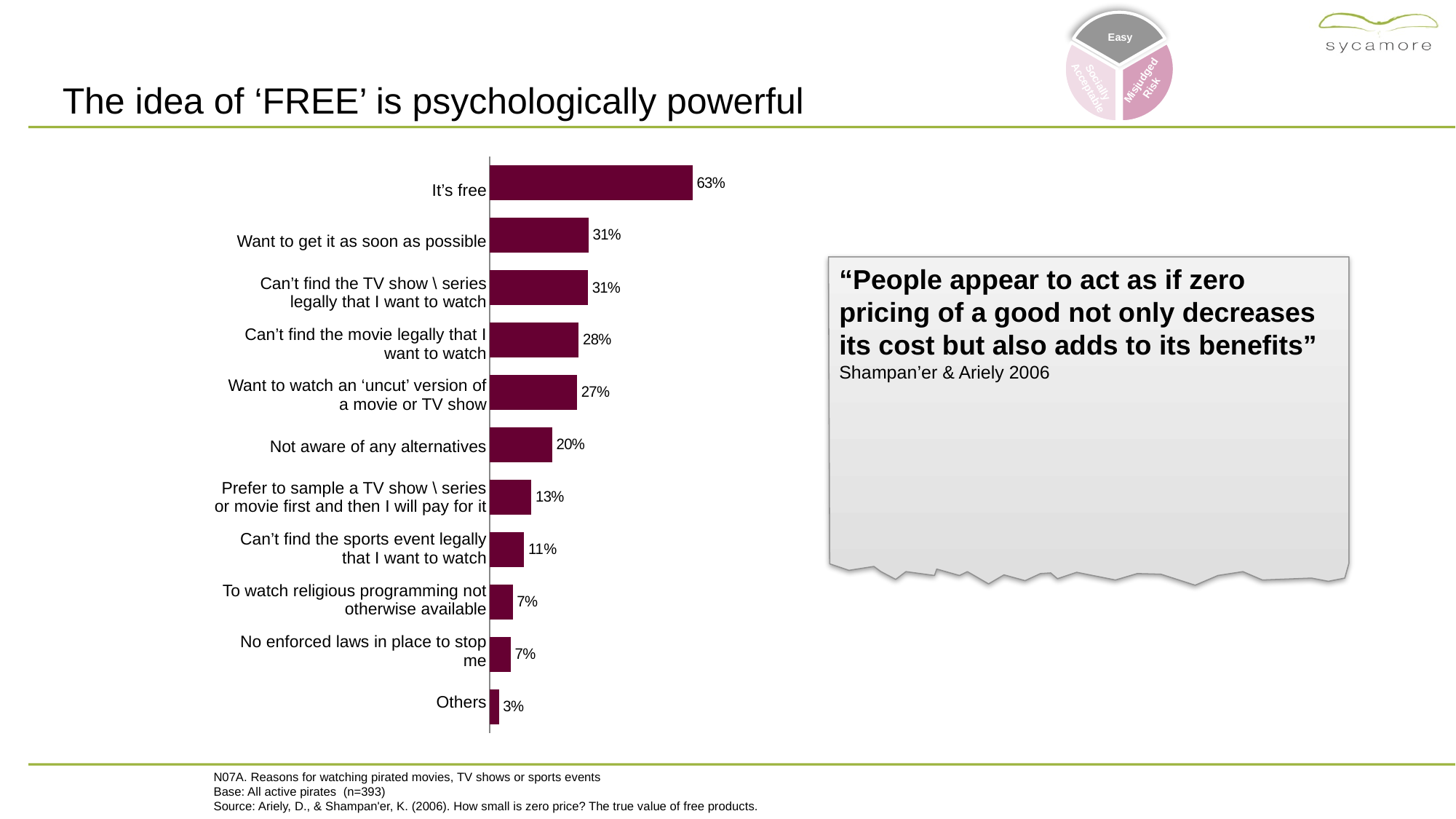
Which two reasons both have a value of 7%? To watch religious programming not otherwise available; No enforced laws in place to stop me Which reason has the highest percentage? It's free How many reasons (categories) are shown in the chart? 11 What is the difference between 'It's free' and 'Want to get it as soon as possible'? 32% What is the base (sample size) stated for the chart? All active pirates (n=393) What is the value for 'Not aware of any alternatives'? 20% Which is larger: 'Not aware of any alternatives' or 'Want to watch an 'uncut' version of a movie or TV show'? Want to watch an 'uncut' version of a movie or TV show What is the difference between 'Can't find the movie legally that I want to watch' and 'Prefer to sample a TV show \ series or movie first and then I will pay for it'? 15% What is the value for 'Can't find the sports event legally that I want to watch'? 11% What percentage of respondents gave 'It's free' as a reason? 63% What kind of chart is shown on the slide? Bar chart Which reason has the lowest percentage? Others